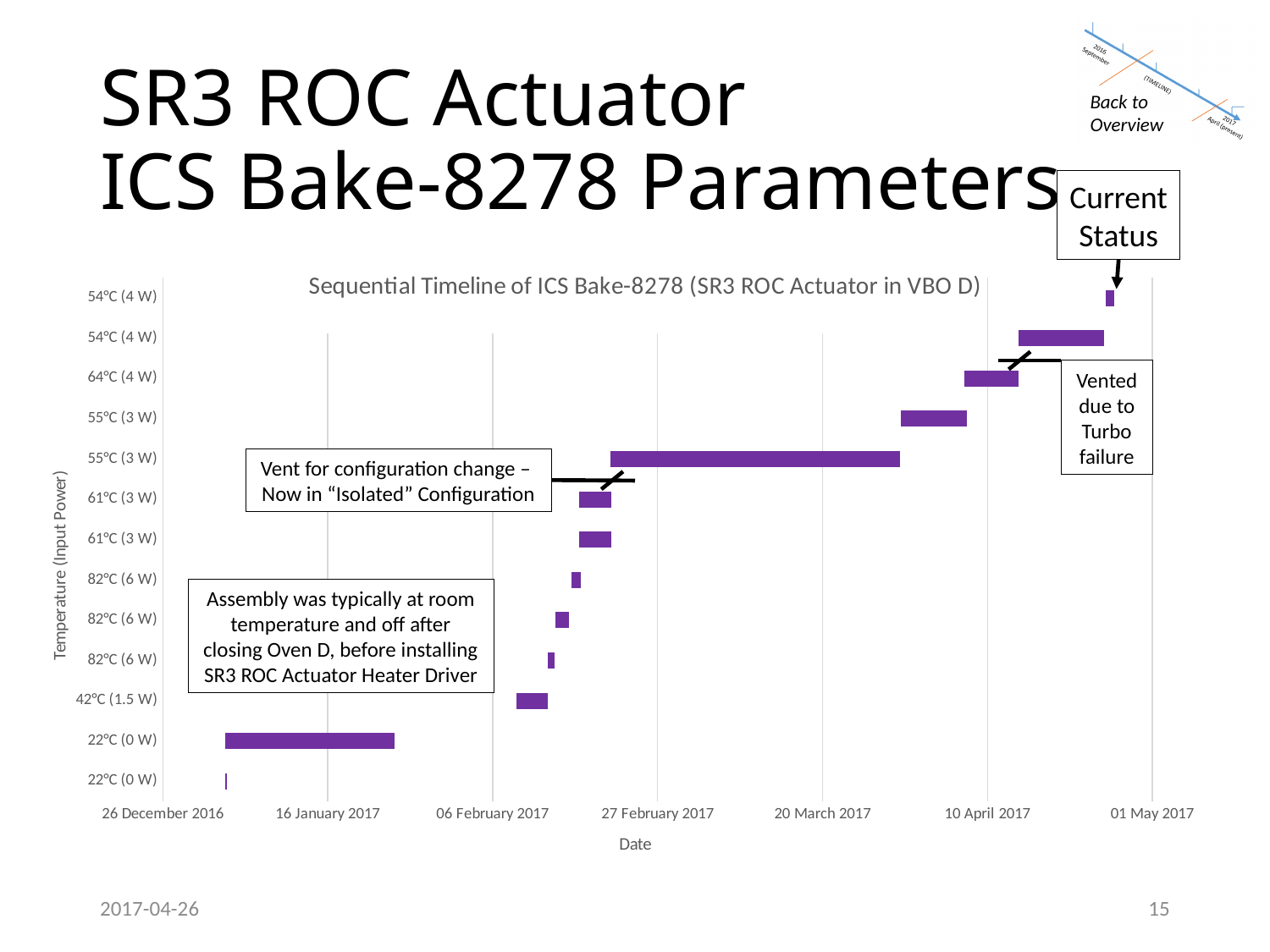
Does the 64°C (4 W) bar start before or after 10 April 2017? before How many date tick labels are shown on the horizontal axis? 7 Which category's bar is the earliest in time (furthest left) on the chart? 22°C (0 W) What is the title of the chart? Sequential Timeline of ICS Bake-8278 (SR3 ROC Actuator in VBO D) Which category has the longest bar in the chart? 55°C (3 W) What kind of chart is shown on the slide? bar chart How many categories are listed on the vertical axis of the chart? 13 Which bar is longer: the 55°C (3 W) bar starting near 27 February 2017 or the 54°C (4 W) bar near the top of the chart? 55°C (3 W) Does the 42°C (1.5 W) bar start before or after 06 February 2017? after Moving up the vertical axis from bottom to top, do the bars occur later or earlier in time? later What is the label of the vertical axis of the chart? Temperature (Input Power) Does the long 22°C (0 W) bar end before or after 06 February 2017? before